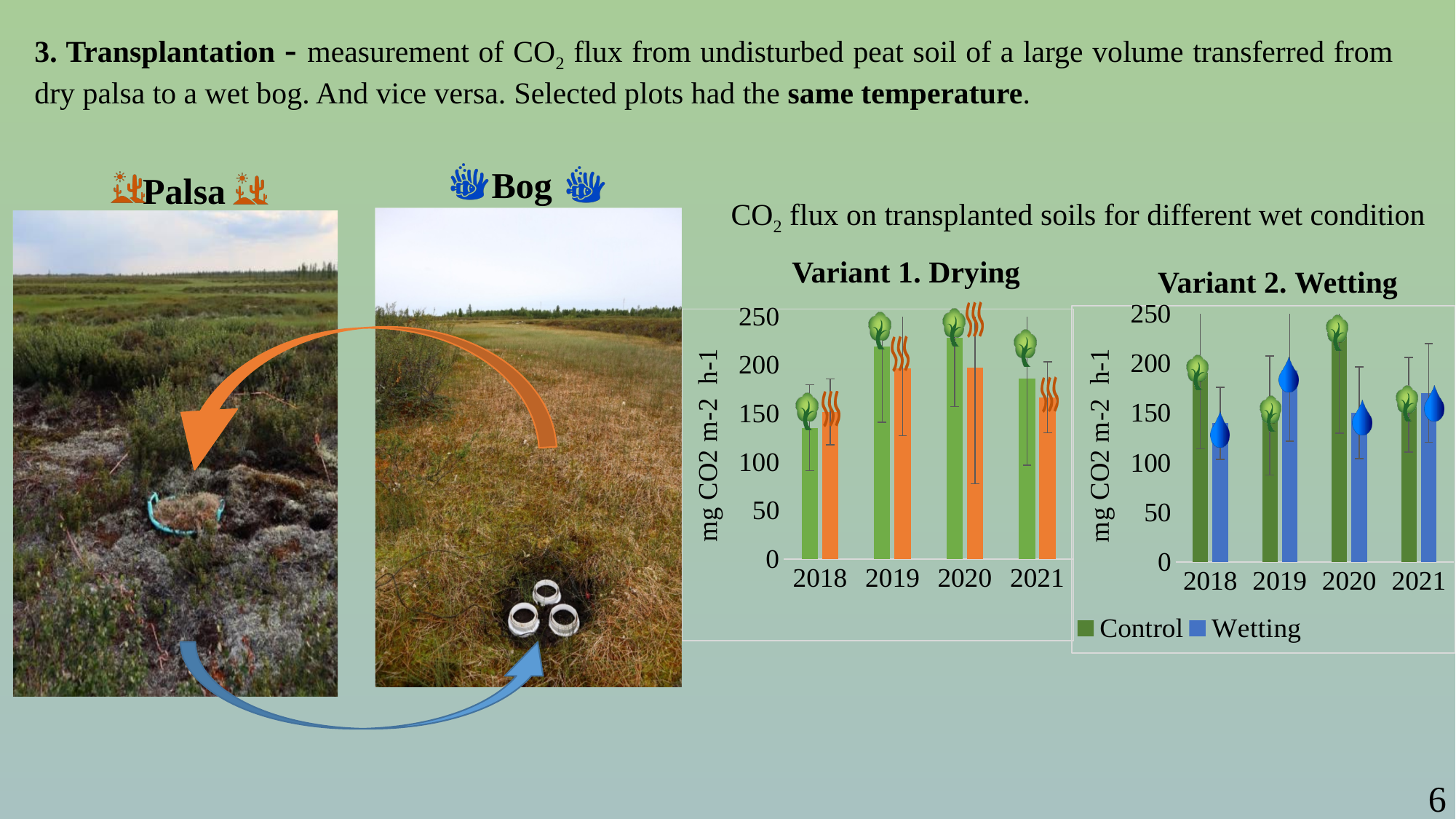
How many series does the legend of the "Variant 2. Wetting" chart list? 2 In the "Variant 2. Wetting" chart, is the Control value for 2020 greater or less than 200? greater What kind of chart is the "Variant 1. Drying" chart? bar chart In the "Variant 2. Wetting" chart, what are the two legend entries? Control and Wetting In the "Variant 1. Drying" chart, is the value of the green bar for 2018 greater or less than 150? less In the "Variant 2. Wetting" chart, which is larger for 2019, Control or Wetting? Wetting What is the y-axis label of the "Variant 1. Drying" chart? mg CO2 m-2 h-1 In the "Variant 2. Wetting" chart, is the Wetting value for 2018 greater or less than 150? less How many years are shown on the x axis of the "Variant 2. Wetting" chart? 4 In the "Variant 2. Wetting" chart, in which year is the Control value highest? 2020 In the "Variant 2. Wetting" chart, which is larger for 2018, Control or Wetting? Control